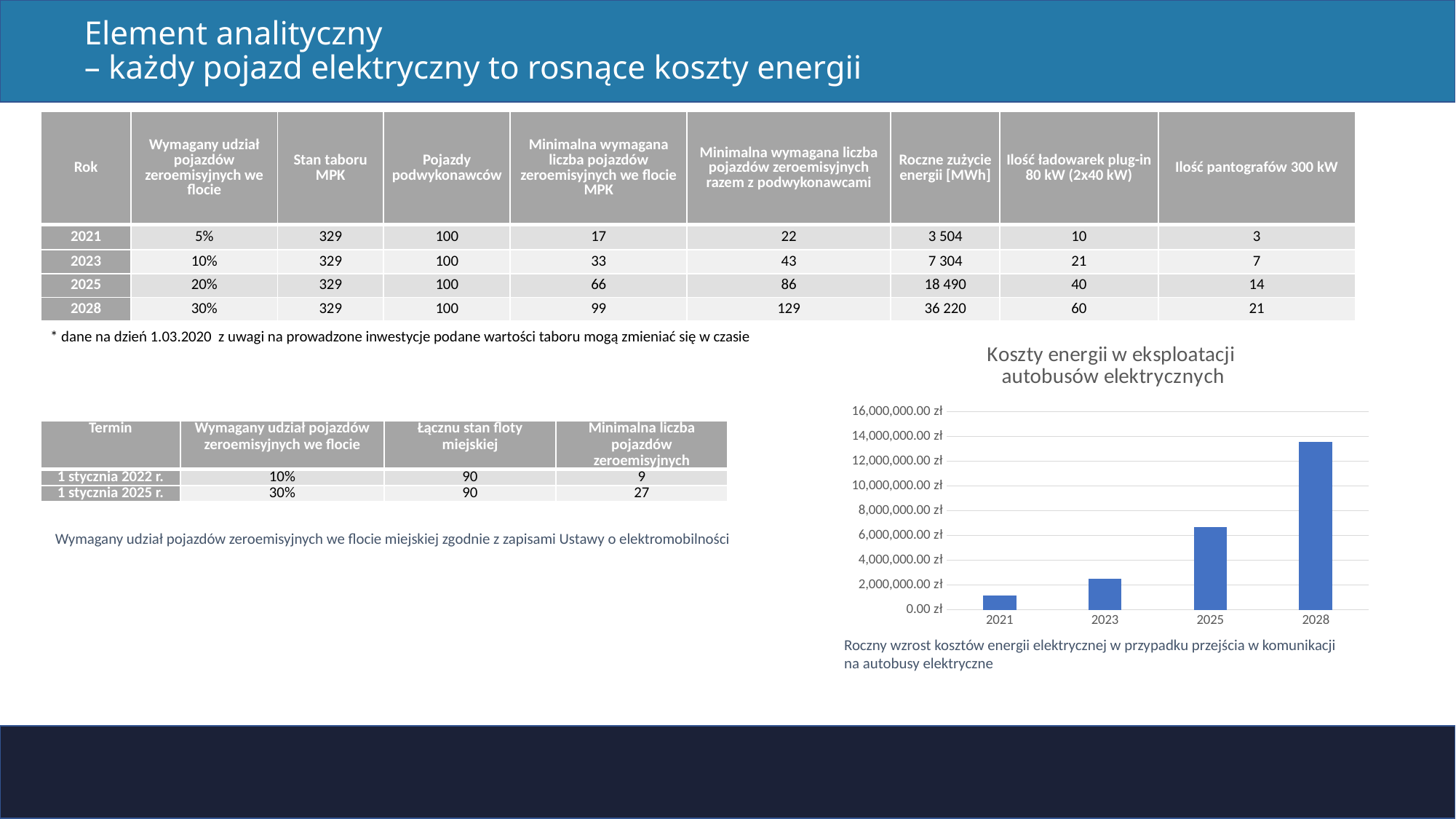
Which year has the lowest energy cost in the chart? 2021 Is the value for 2028 greater or less than 12,000,000.00 zł? greater Which year has the highest energy cost in the chart? 2028 Is the value for 2025 greater or less than 4,000,000.00 zł? greater Is the value for 2021 greater or less than 2,000,000.00 zł? less Do the energy costs rise or fall from 2021 to 2028 in the chart? rise What kind of chart is shown on the slide? bar chart What is the title of the chart on the slide? Koszty energii w eksploatacji autobusów elektrycznych What is the highest value shown on the y axis of the chart? 16,000,000.00 zł How many years are shown on the x axis of the chart? 4 Which year has the larger energy cost in the chart, 2023 or 2025? 2025